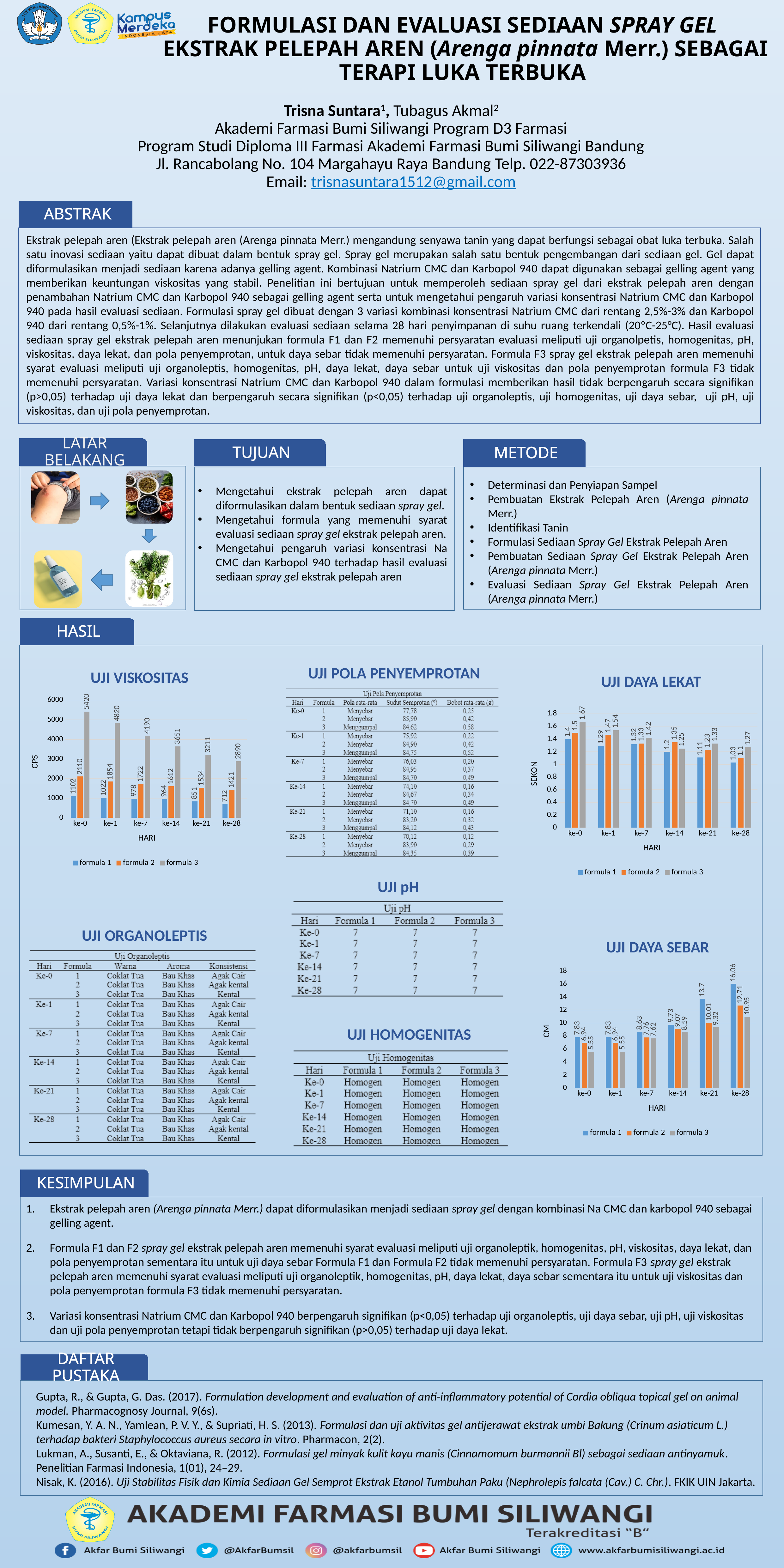
In the UJI VISKOSITAS chart, what is the difference between formula 3 and formula 2 at ke-0? 3310 In the UJI VISKOSITAS chart, what is the value for formula 1 at ke-28? 712 In the UJI DAYA SEBAR chart, how many series does the legend list? 3 In the UJI VISKOSITAS chart, how many categories are shown on the x axis? 6 In the UJI DAYA SEBAR chart, which formula has the highest value at ke-21? formula 1 In the UJI DAYA LEKAT chart, what is the label of the y axis? SEKON In the UJI VISKOSITAS chart, what is the value for formula 3 at ke-0? 5420 In the UJI VISKOSITAS chart, does the value for formula 3 rise or fall from ke-0 to ke-28? fall In the UJI DAYA SEBAR chart, what is the value for formula 1 at ke-28? 16.06 In the UJI DAYA LEKAT chart, what is the value for formula 3 at ke-0? 1.67 What kind of chart is the UJI DAYA SEBAR chart? bar chart In the UJI DAYA LEKAT chart, which formula has the lowest value at ke-28? formula 1